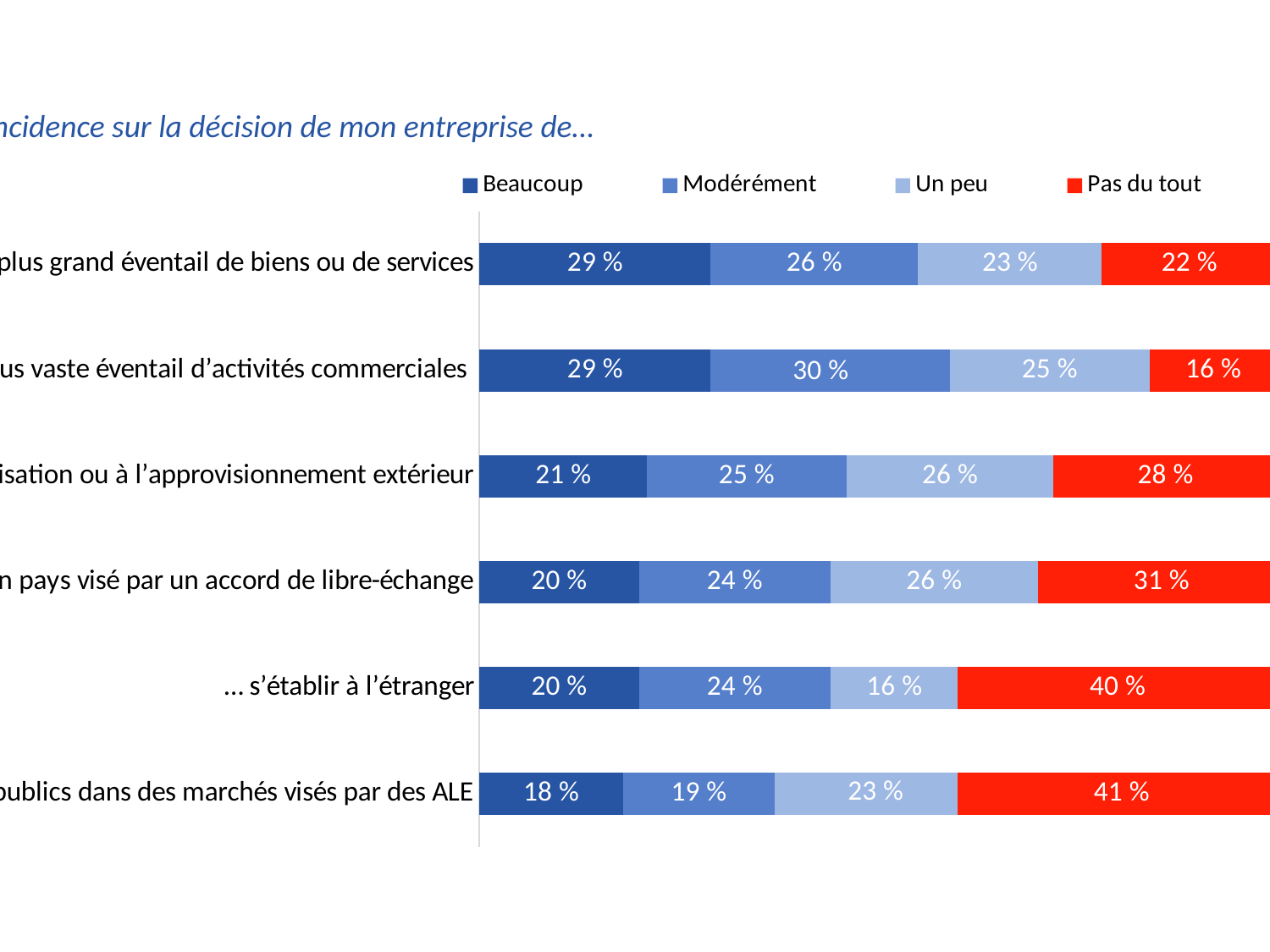
What is the 'Pas du tout' value for '… s'établir à l'étranger'? 40 % What is the difference between the 'Pas du tout' and 'Beaucoup' values for '… s'établir à l'étranger'? 20 % Which series has the largest segment in the '… s'établir à l'étranger' bar? Pas du tout How many bars (categories) are plotted in the chart? 6 What is the 'Un peu' value for '… s'établir à l'étranger'? 16 % Which series has the smallest segment in the '… s'établir à l'étranger' bar? Un peu What is the 'Beaucoup' value for '… s'établir à l'étranger'? 20 % What kind of chart is shown on the slide? Stacked bar chart Which is larger: the 'Pas du tout' value for '… s'établir à l'étranger' or the 'Pas du tout' value for the top bar? … s'établir à l'étranger What colour represents the 'Pas du tout' series in the legend? Red What is the total of the '… s'établir à l'étranger' bar? 100 % How many series does the chart legend list? 4